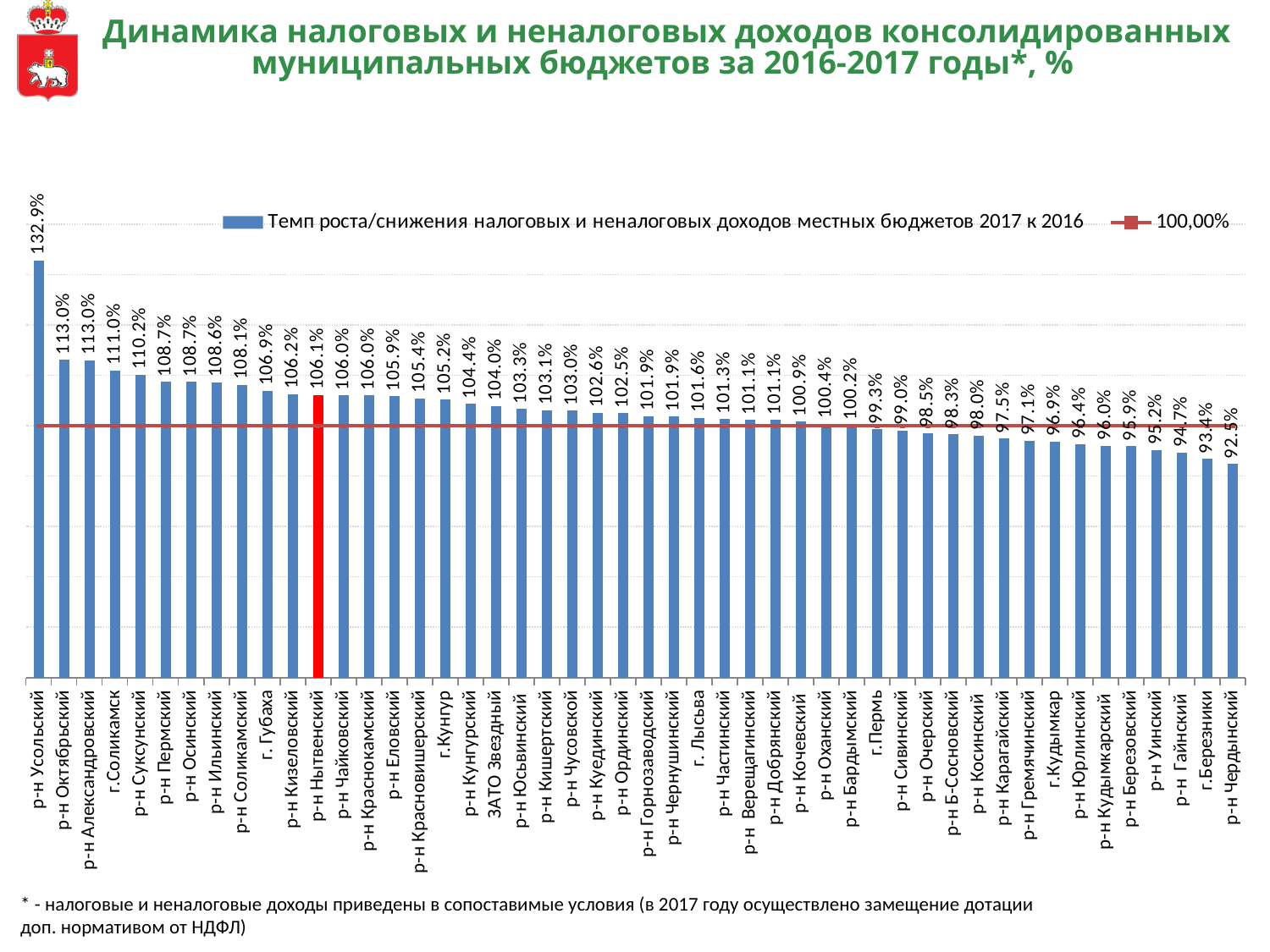
What is the value for р-н Нытвенский, shown with the red bar? 106.1% Which is larger, the value for г.Соликамск or the value for г.Кунгур? г.Соликамск Do the bar values rise or fall from left to right along the x axis? fall What is the difference between the values for р-н Усольский and р-н Чердынский? 40.4% How many categories are shown on the x axis? 48 What kind of chart is shown on the slide? bar chart What is the value for р-н Усольский? 132.9% How many entries does the legend list? 2 Which category has the highest value? р-н Усольский Which category has the lowest value? р-н Чердынский What is the value for г.Пермь? 99.3% What is the value for г.Березники? 93.4%